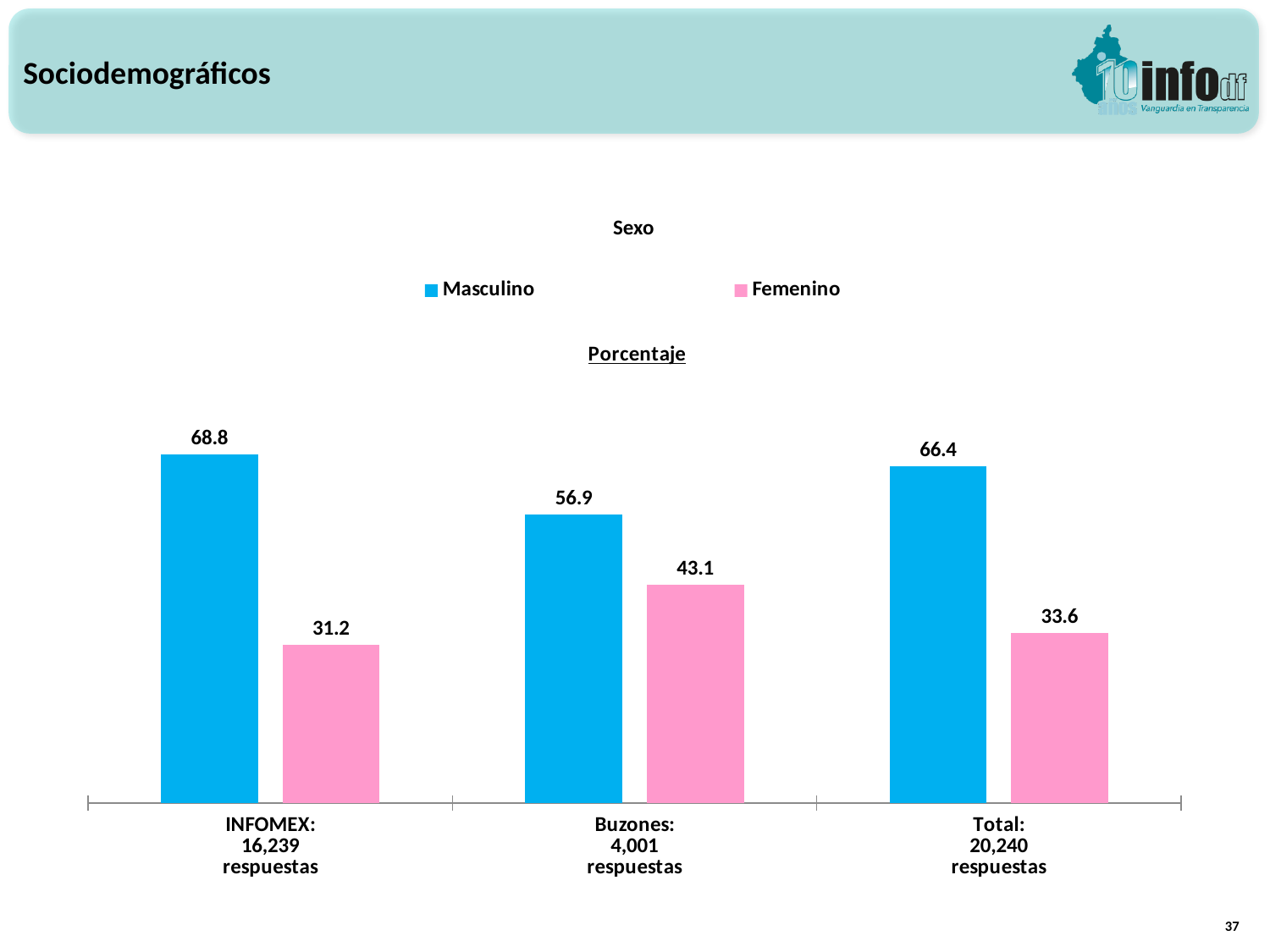
What is the Masculino value for Buzones? 56.9 Which is larger, the Femenino value for Buzones or the Femenino value for Total? Buzones What is the difference between the Masculino values for INFOMEX and Buzones? 11.9 How many series does the legend list? 2 What is the Femenino value for Total? 33.6 What is the Femenino value for Buzones? 43.1 Which category has the lowest Femenino value? INFOMEX What kind of chart is shown on the slide? Bar chart How many categories are shown on the x axis? 3 Which category has the highest Masculino value? INFOMEX What is the difference between the Masculino and Femenino values for Total? 32.8 What is the Masculino value for INFOMEX? 68.8